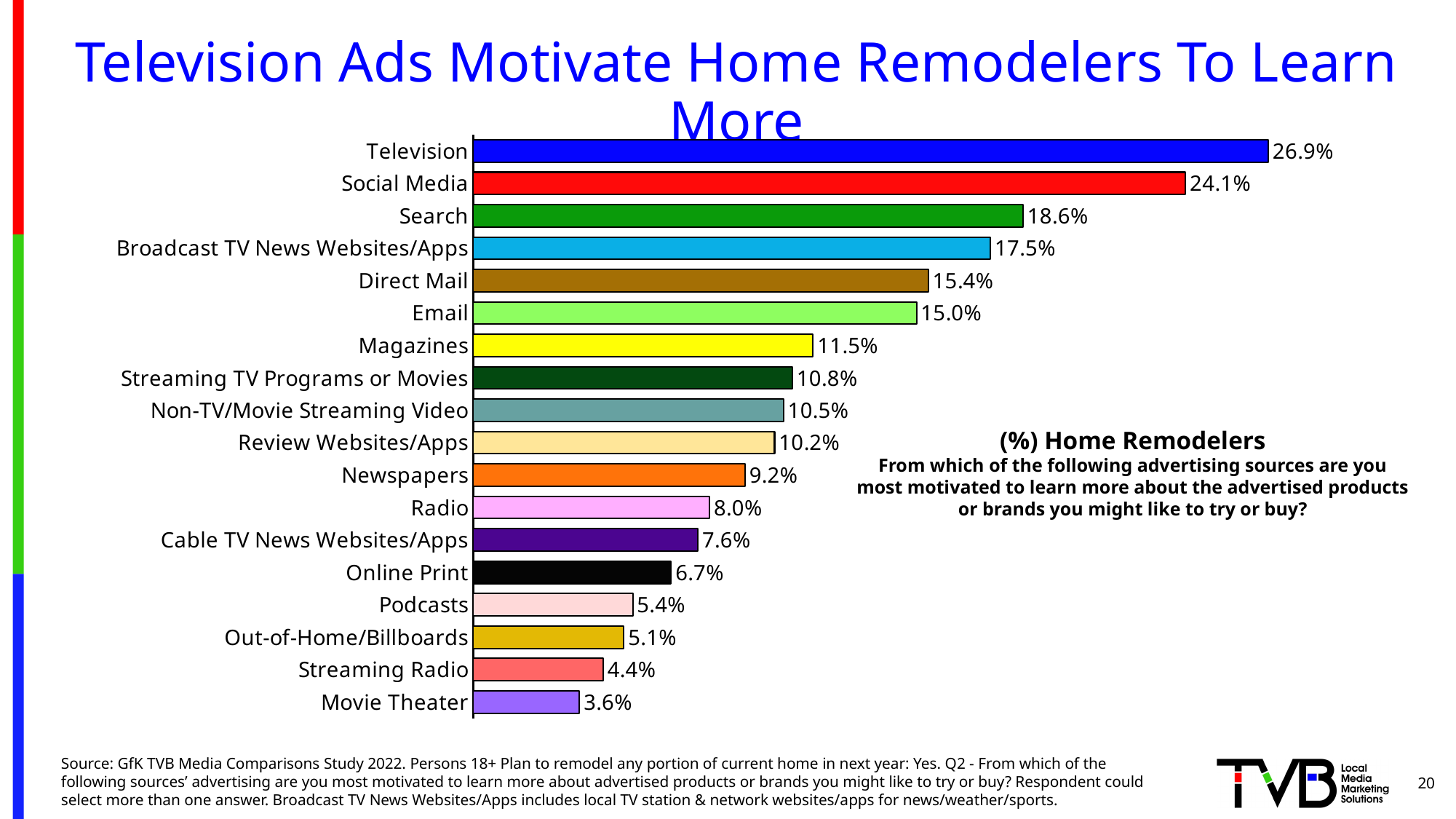
What is the value shown for Podcasts? 5.4% What percentage of home remodelers are most motivated to learn more by Television ads? 26.9% What kind of chart is shown on the slide? Bar chart How many advertising sources are shown on the chart? 18 What is the value shown for Direct Mail? 15.4% Which has a larger value, Magazines or Newspapers? Magazines Which advertising source has the highest value on the chart? Television What colour is the bar for Social Media? Red What is the difference between the values for Search and Radio? 10.6% Which advertising source has the lowest value on the chart? Movie Theater Which has a larger value, Online Print or Cable TV News Websites/Apps? Cable TV News Websites/Apps What is the difference between the values for Television and Social Media? 2.8%